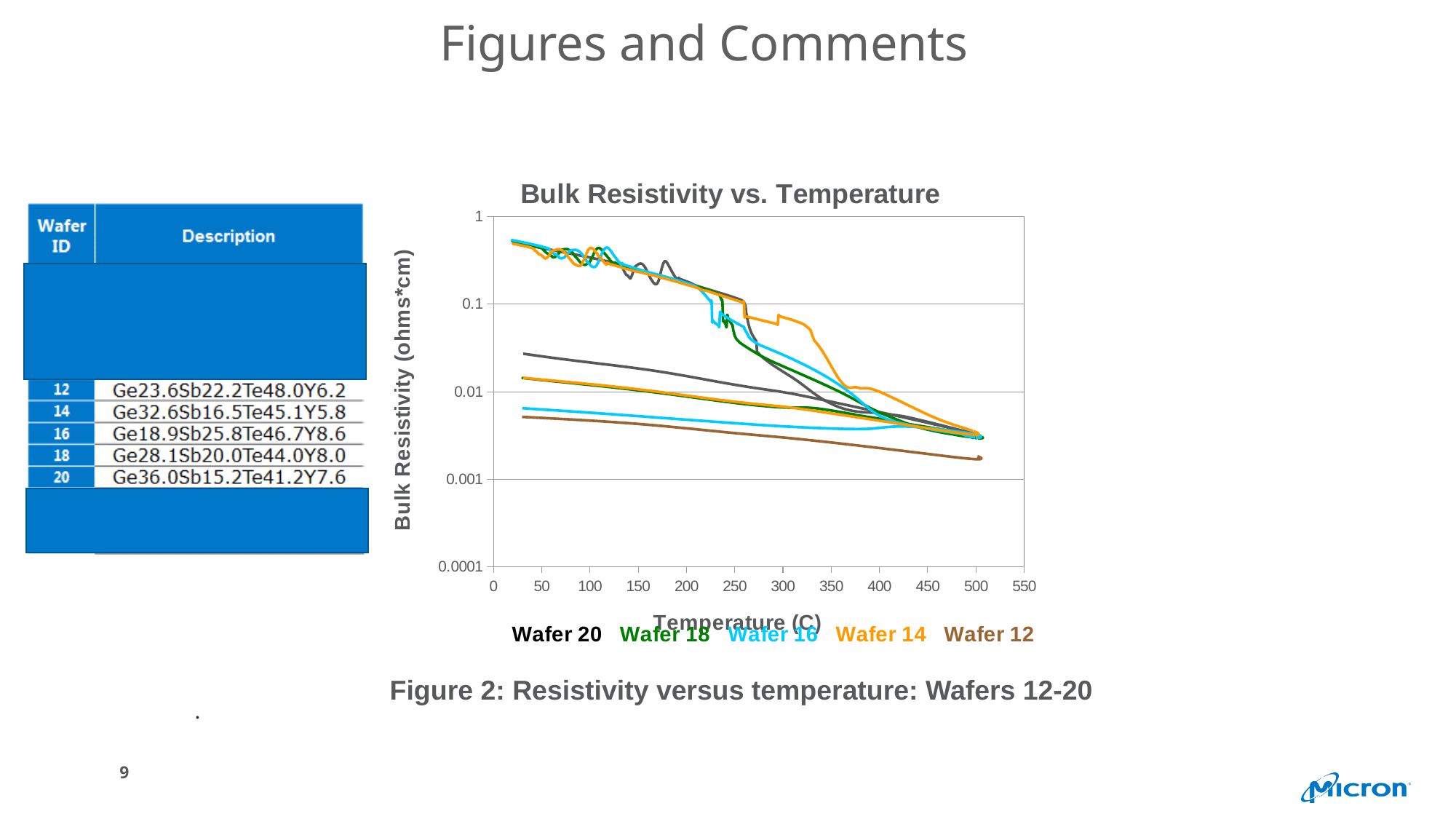
Is the value for Wafer 12 at 500 C greater or less than 0.01? less What is the label of the y axis of the chart? Bulk Resistivity (ohms*cm) Which wafer has the lowest bulk resistivity at 500 C? Wafer 12 Do the bulk resistivity values rise or fall as temperature increases along the x axis? Fall Is the value for Wafer 12 at 300 C greater or less than 0.001? greater How many series does the legend of the chart list? 5 What is the highest value shown on the y axis of the chart? 1 At 500 C, which is larger: the value for Wafer 12 or the value for Wafer 14? Wafer 14 What is the title of the chart? Bulk Resistivity vs. Temperature Is the highest value for Wafer 14 at 50 C greater or less than 0.1? greater What kind of chart is shown on the slide? Line chart